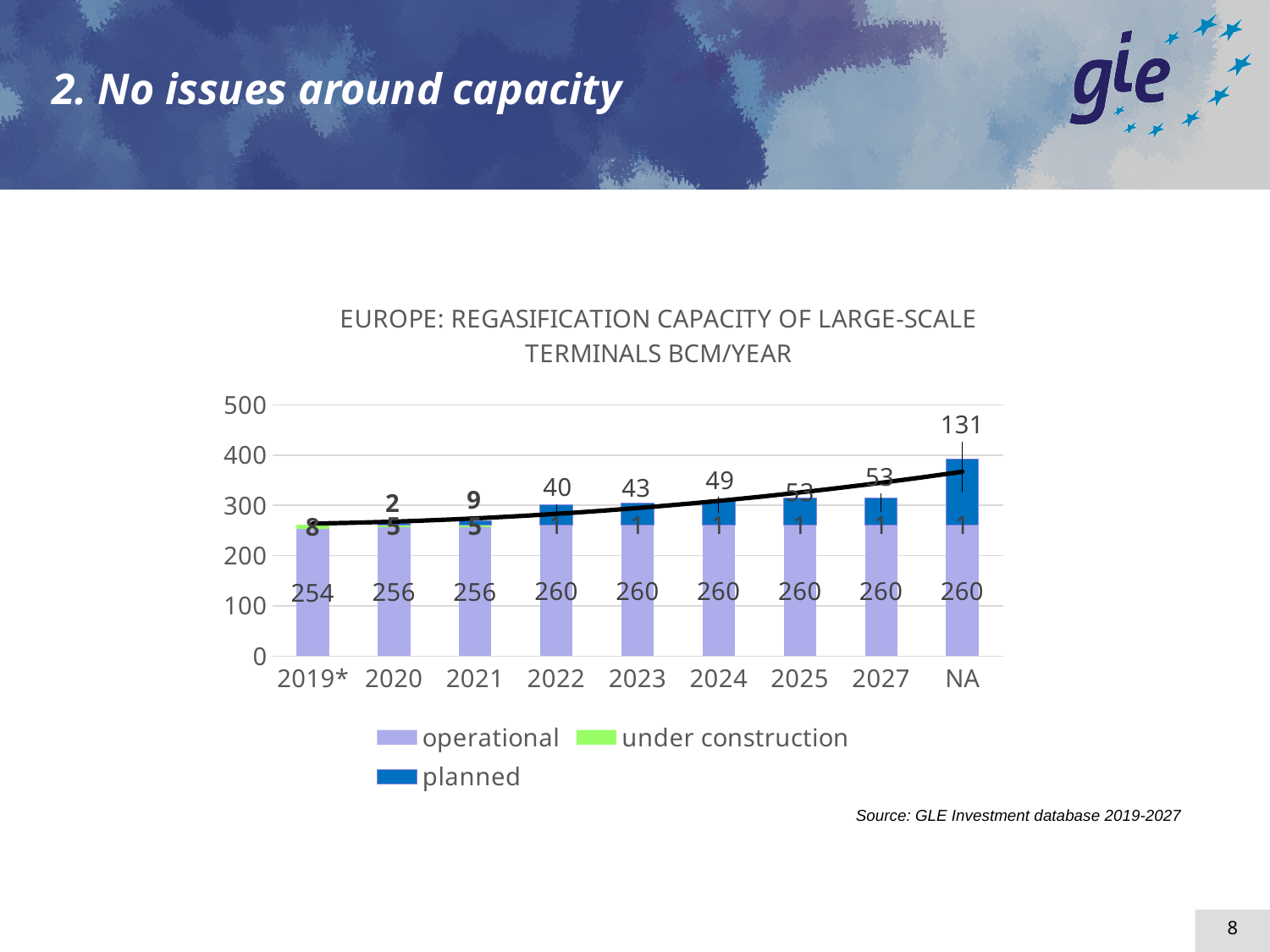
What is the planned capacity for 2024? 49 How many categories are shown on the x axis? 9 Do the total bar heights rise or fall from 2019* to NA along the x axis? rise How many series does the legend list? 3 What is the planned capacity for NA? 131 What is the operational capacity for 2019*? 254 What is the difference between the planned capacity for NA and for 2027? 78 Is the total height of the NA bar greater or less than 300? greater What kind of chart is shown on the slide? combination bar and line chart Which is larger, the planned capacity for 2022 or for 2023? 2023 Which category has the highest planned capacity? NA Which category has the lowest operational capacity? 2019*